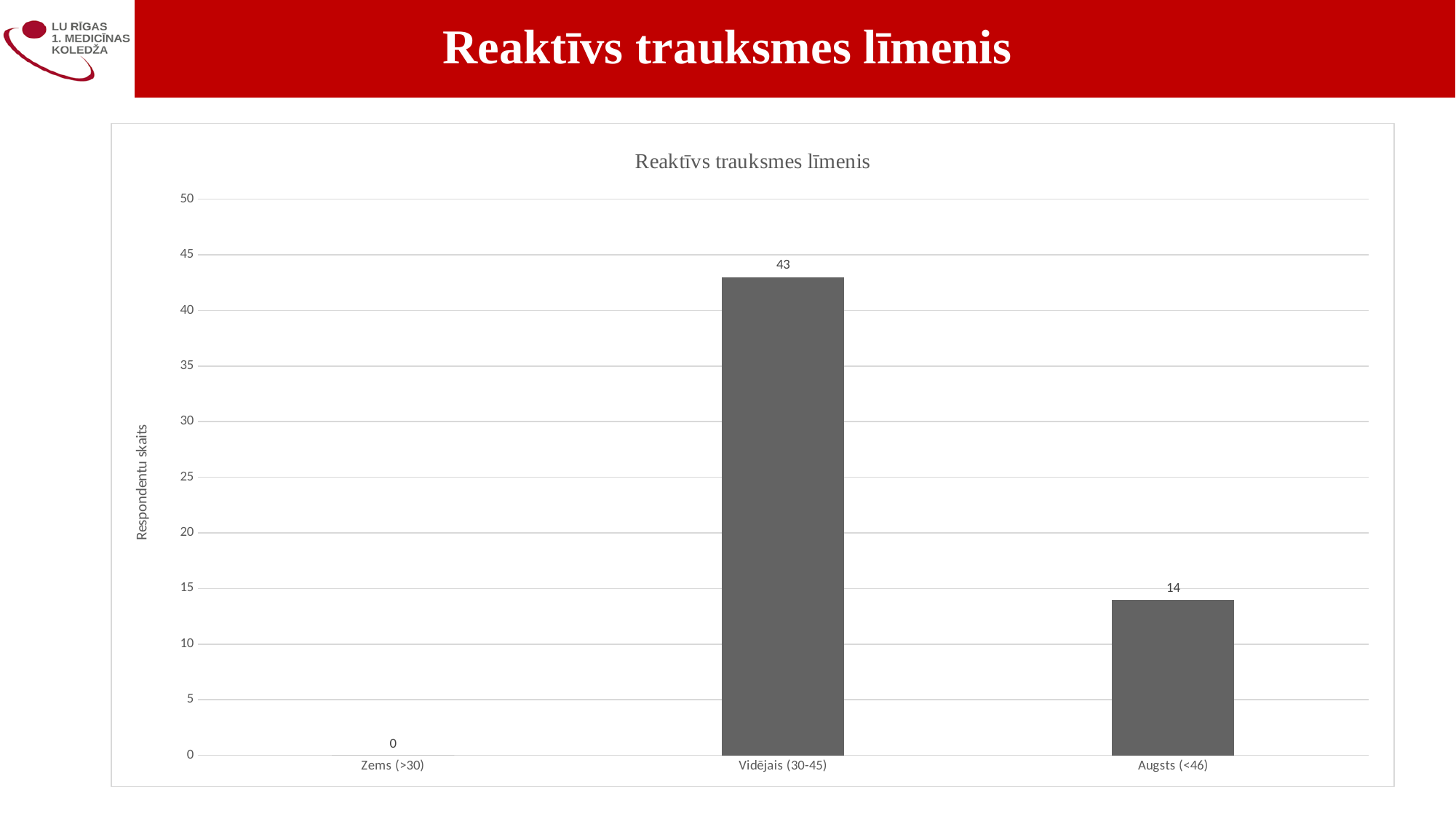
What is the label of the vertical axis? Respondentu skaits What is the title of the chart? Reaktīvs trauksmes līmenis Which category has the highest value? Vidējais (30-45) Is the value for Vidējais (30-45) greater or less than 40? greater What kind of chart is shown on the slide? bar chart What is the value for Augsts (<46)? 14 How many categories are shown on the x axis? 3 Which category has the lowest value? Zems (>30) What is the difference between the values for Vidējais (30-45) and Augsts (<46)? 29 What is the value for Zems (>30)? 0 Which is larger, the value for Augsts (<46) or the value for Zems (>30)? Augsts (<46) What is the value for Vidējais (30-45)? 43